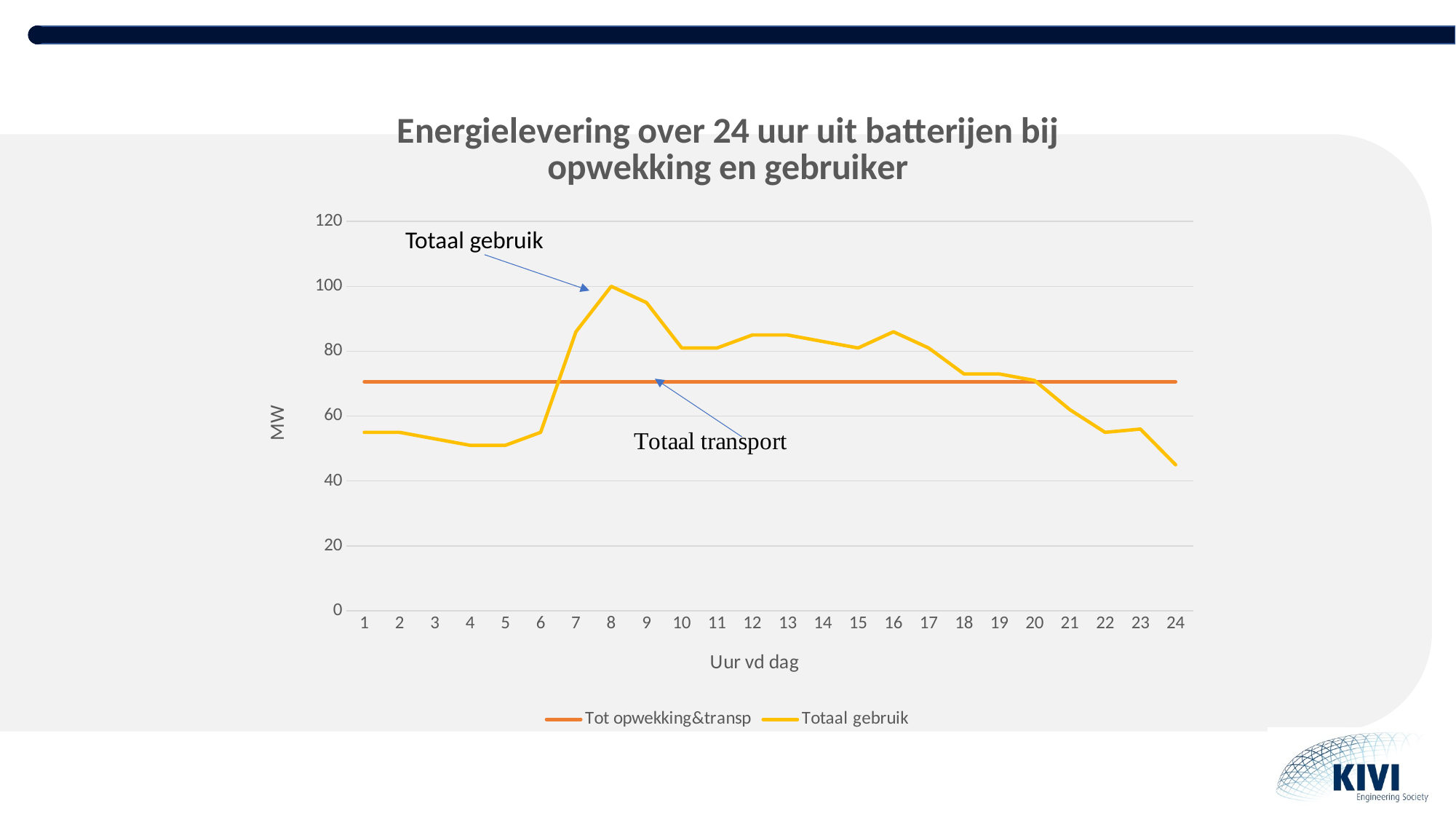
What kind of chart is shown on the slide? line chart At which hour is the Totaal gebruik series at its lowest value? 24 Is the Totaal gebruik value at hour 16 greater or less than 80? greater Is the Totaal gebruik value at hour 1 greater or less than 60? less Does the Totaal gebruik series rise or fall from hour 16 to hour 24? fall Is the Tot opwekking&transp value greater or less than 60? greater How many series does the legend list? 2 How many hours (points) are plotted along the x axis? 24 At which hour does the Totaal gebruik series reach its highest value? 8 What is the label on the y axis of the chart? MW At hour 2, which series has the larger value: Totaal gebruik or Tot opwekking&transp? Tot opwekking&transp At hour 8, which series has the larger value: Totaal gebruik or Tot opwekking&transp? Totaal gebruik